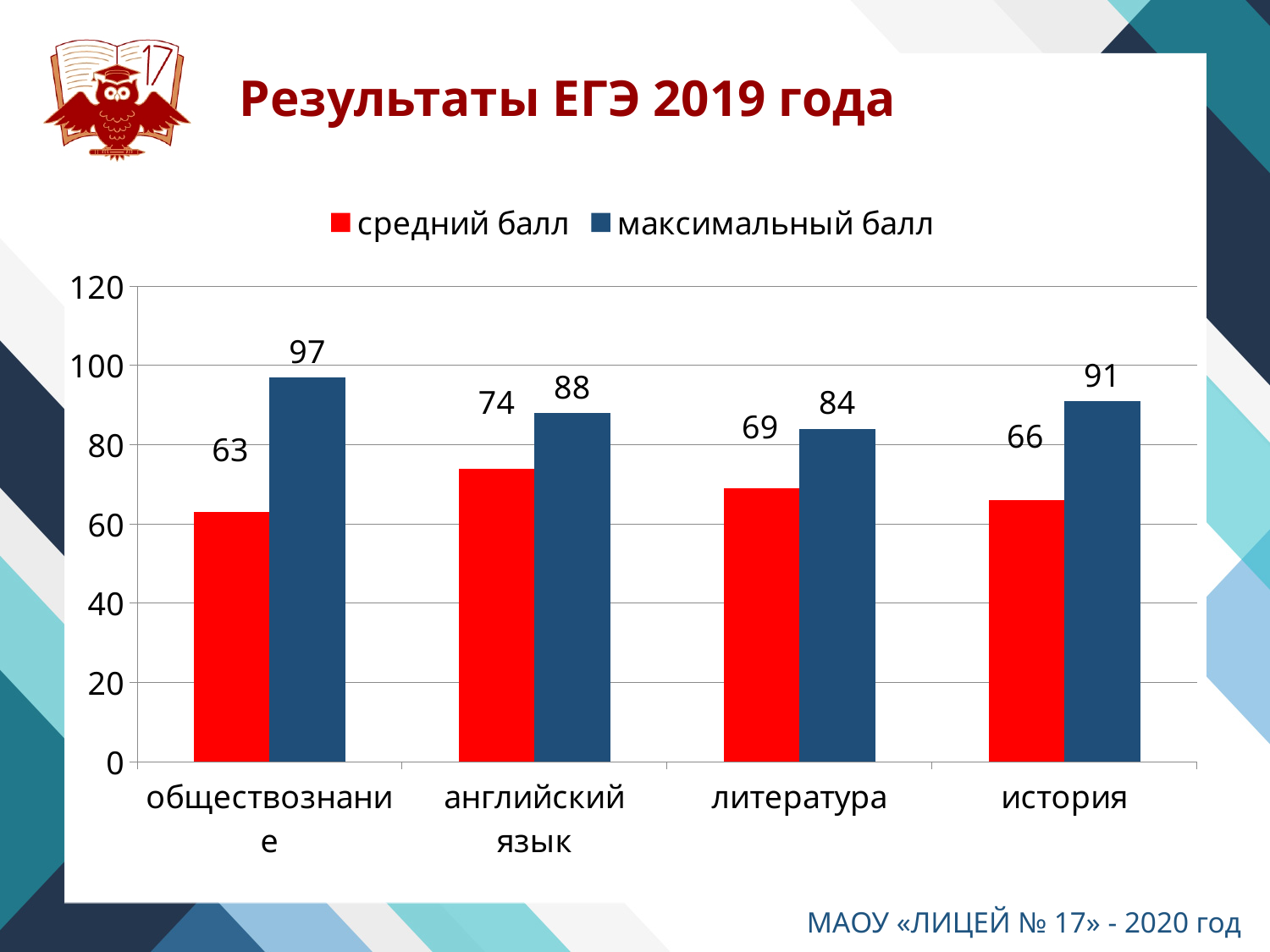
What is the difference between the средний балл for английский язык and for история? 8 How many series does the legend list? 2 How many subjects are shown on the x axis? 4 What kind of chart is shown on the slide? bar chart What is the средний балл for английский язык? 74 Which subject has the lowest средний балл? обществознание What is the difference between the максимальный балл and the средний балл for обществознание? 34 What colour are the bars for средний балл? red Which subject has the highest максимальный балл? обществознание Which is larger: the максимальный балл for английский язык or for литература? английский язык What is the максимальный балл for история? 91 What is the средний балл for литература? 69